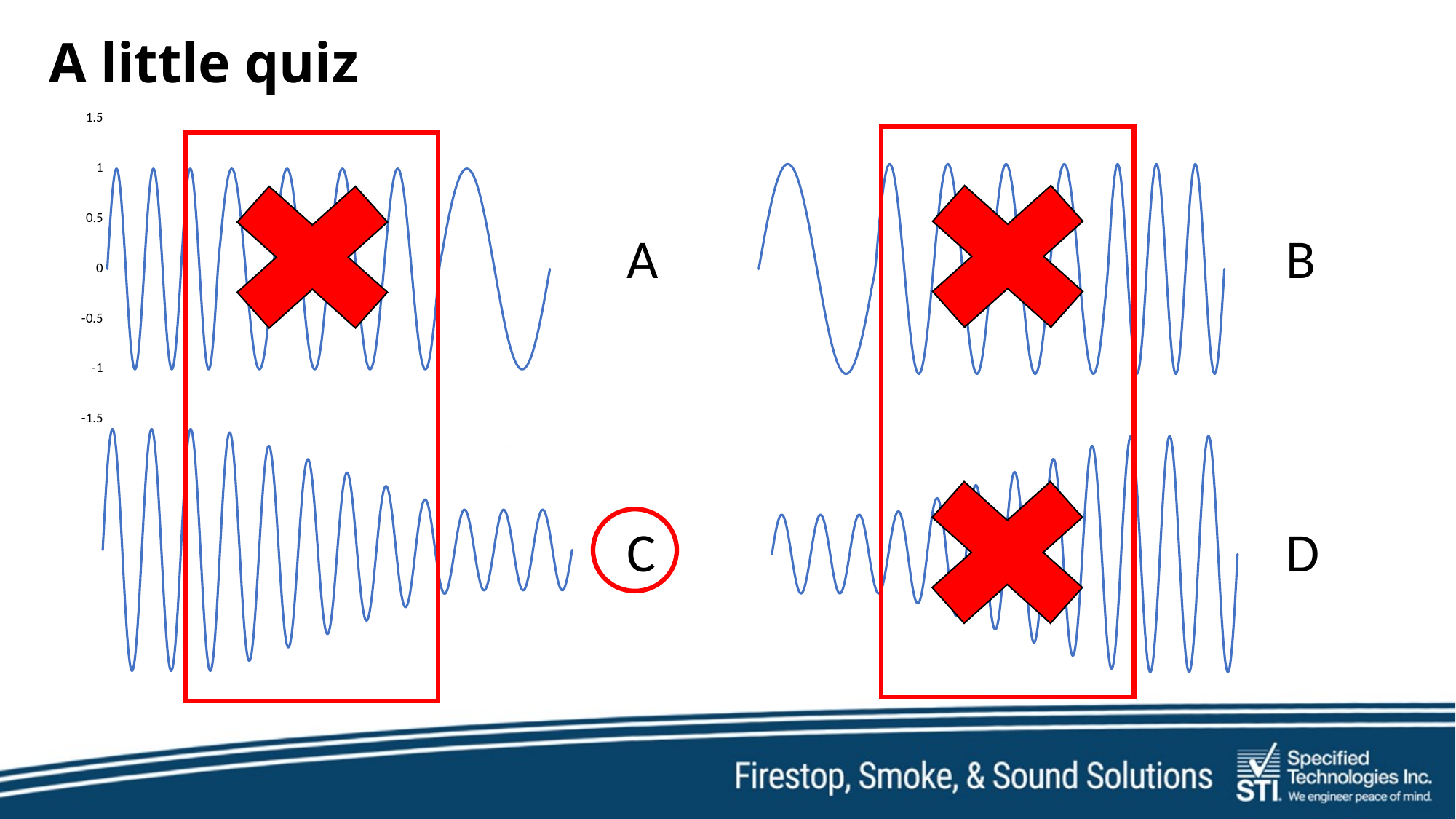
Which chart label is circled in red on the slide? C In chart D, does the amplitude of the wave increase or decrease from left to right? increase What is the lowest value shown on the y axis of chart A? -1.5 What kind of chart is chart A? line chart In chart C, does the amplitude of the wave increase or decrease from left to right? decrease In chart A, what value do the troughs of the wave reach? -1 In chart B, do the wave cycles get shorter or longer from left to right? shorter What is the title of the slide containing the charts? A little quiz What is the highest value shown on the y axis of chart A? 1.5 How many waveform charts are shown on the slide? 4 In chart A, what value do the peaks of the wave reach? 1